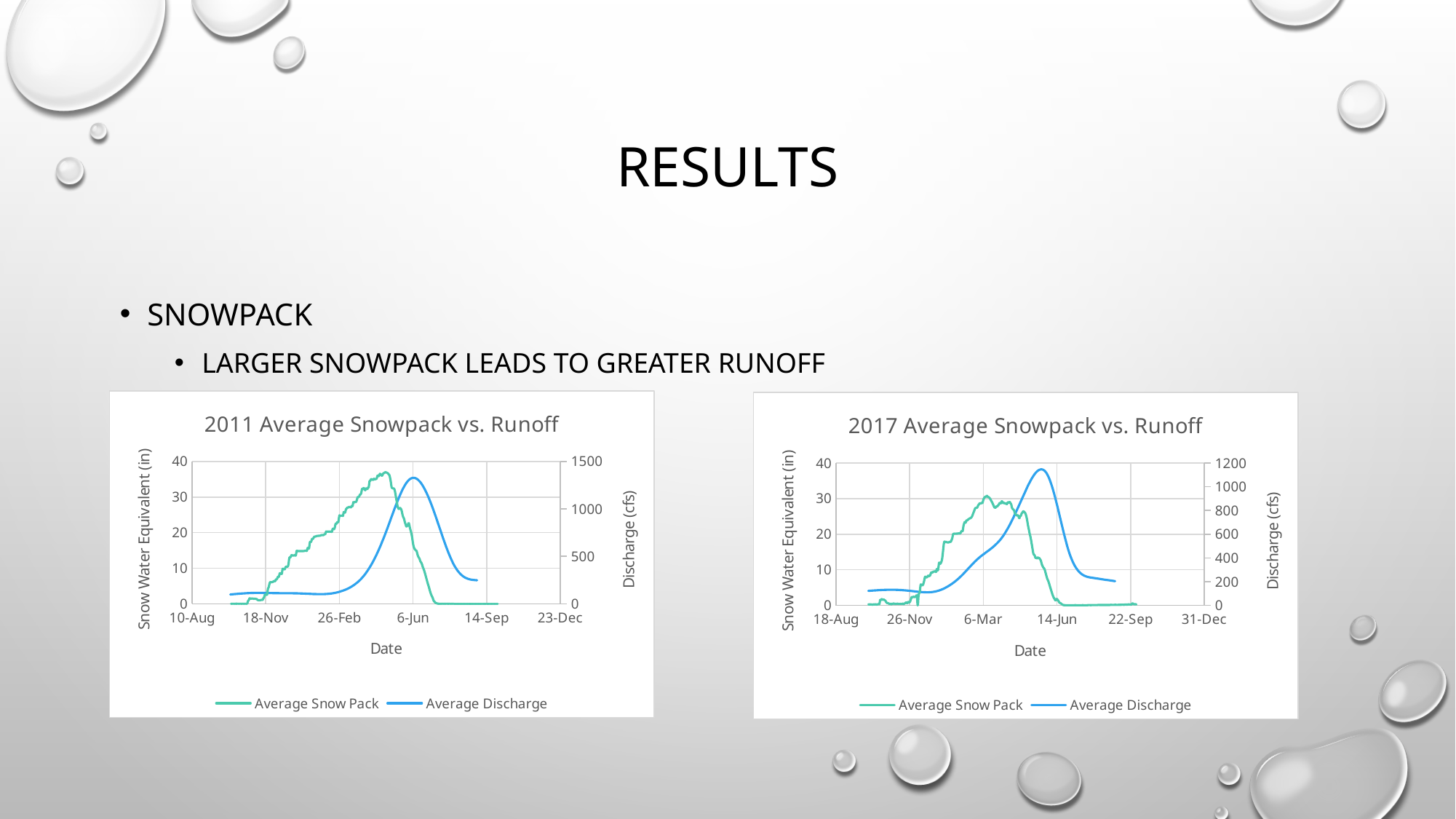
In the 2011 Average Snowpack vs. Runoff chart, is the peak value of Average Snow Pack greater or less than 30? greater In the 2017 Average Snowpack vs. Runoff chart, is the peak value of Average Snow Pack greater or less than 20? greater In the 2017 Average Snowpack vs. Runoff chart, is the peak value of Average Discharge greater or less than 1000? greater How many series does the legend of the 2017 Average Snowpack vs. Runoff chart list? 2 What is the label of the left-hand vertical axis in the 2011 Average Snowpack vs. Runoff chart? Snow Water Equivalent (in) What kind of chart is the 2011 Average Snowpack vs. Runoff chart? line chart In the 2017 Average Snowpack vs. Runoff chart, does Average Snow Pack rise or fall between 26-Nov and 6-Mar? rise In the 2011 Average Snowpack vs. Runoff chart, does Average Discharge rise or fall between 6-Jun and 14-Sep? fall What is the highest tick on the right-hand Discharge axis of the 2017 Average Snowpack vs. Runoff chart? 1200